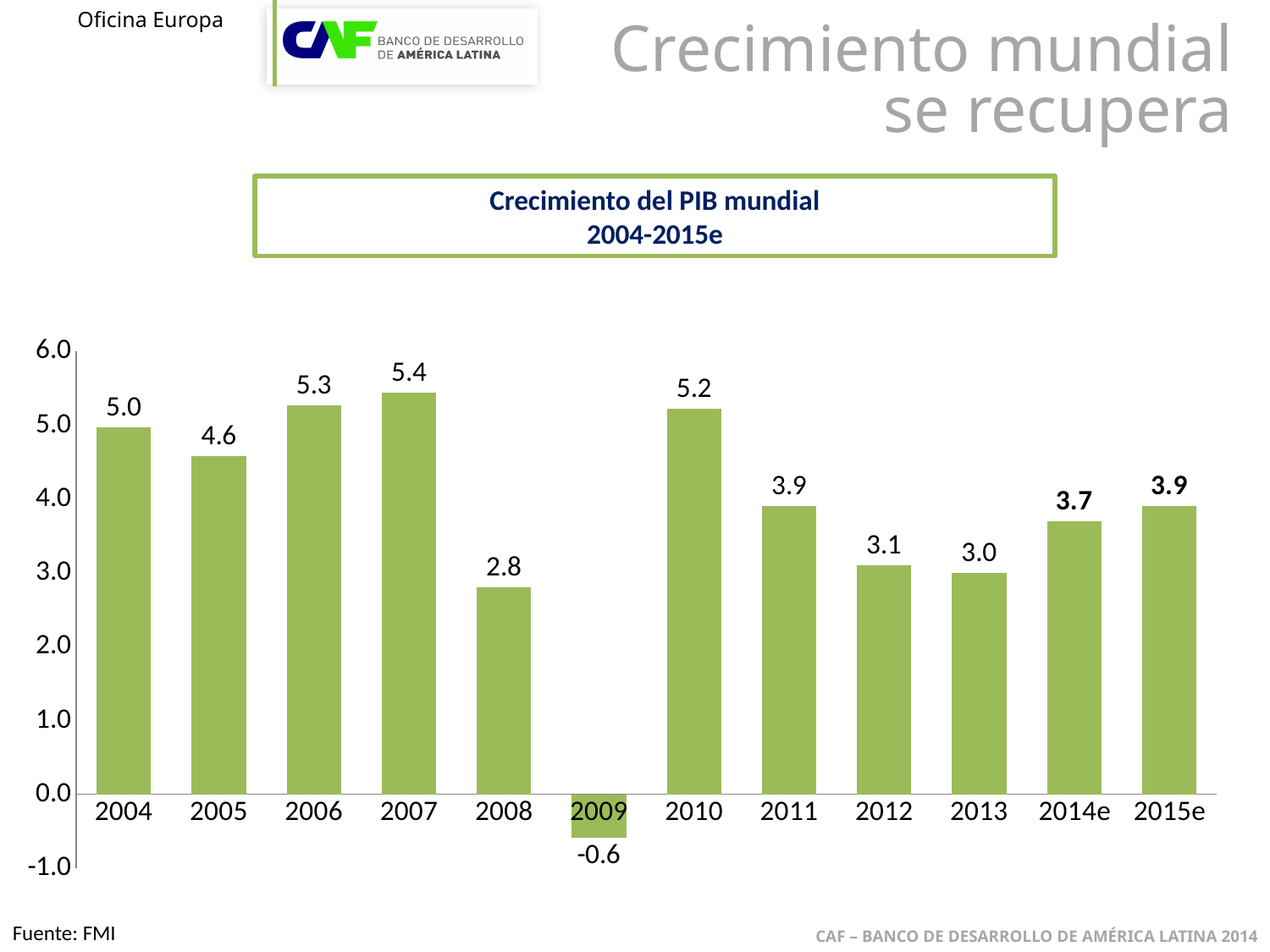
Which year has the lowest value? 2009 How many years are shown on the x axis? 12 What is the value for 2014e? 3.7 What is the value for 2009? -0.6 Which year has the highest value? 2007 What is the difference between the values for 2007 and 2008? 2.6 What is the title of the chart? Crecimiento del PIB mundial 2004-2015e What is the value for 2008? 2.8 What kind of chart is shown? bar chart Which is larger, the value for 2010 or the value for 2011? 2010 Is the value for 2013 greater or less than 4.0? less Do the values rise or fall from 2010 to 2013? fall